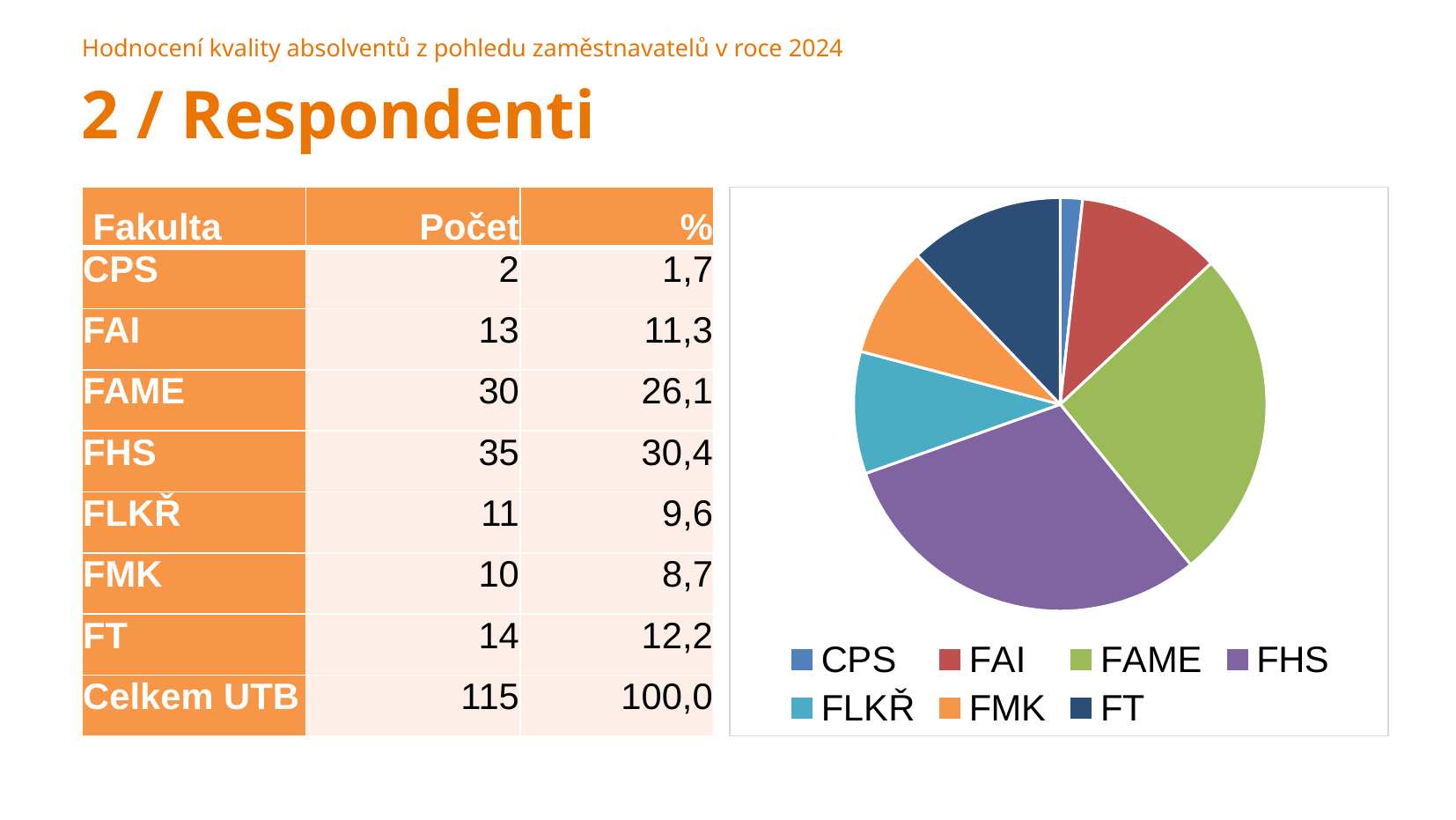
How many slices does the pie chart have? 7 According to the table on the slide, how many respondents (Počet) does the FT slice represent? 14 How many entries does the pie chart's legend list? 7 What kind of chart is shown on the slide? pie chart According to the table on the slide, what is the difference in respondent count between FHS and FAME? 5 According to the table on the slide, what share of respondents does the FHS slice represent? 30,4 Is the slice for FT larger or smaller than the slice for FHS? smaller Is the slice for FAME larger or smaller than the slice for FAI? larger Which colour is used for the FAME slice in the pie chart? green Which faculty has the largest slice of the pie chart? FHS According to the table on the slide, what share of respondents does the FAME slice represent? 26,1 Which faculty has the smallest slice of the pie chart? CPS